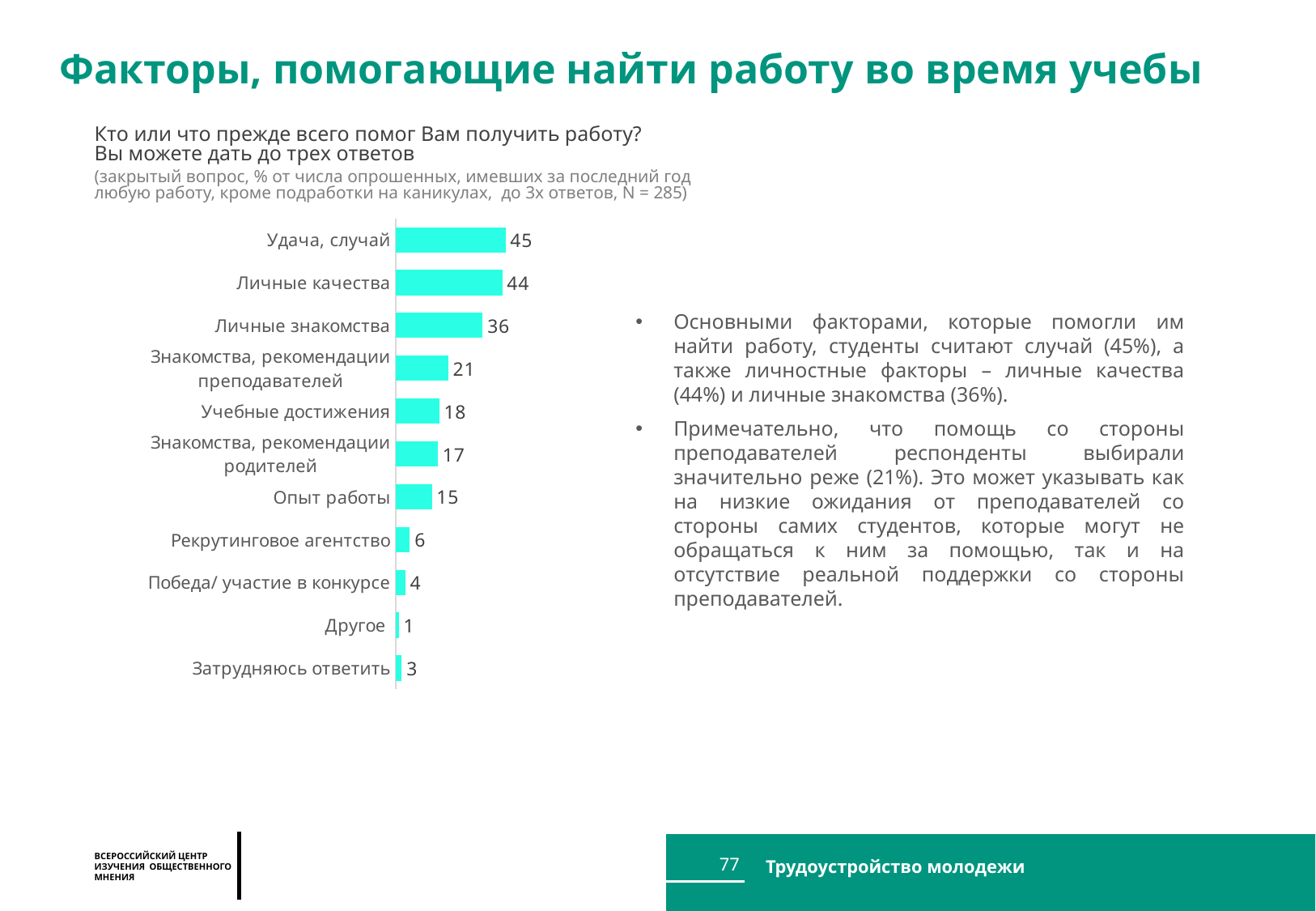
Which category has the lowest value? Другое What value is shown for «Учебные достижения»? 18 What is the difference between «Личные качества» and «Личные знакомства»? 8 What value is shown for «Рекрутинговое агентство»? 6 What is the sample size (N) stated in the chart subtitle? 285 What is the difference between «Знакомства, рекомендации преподавателей» and «Знакомства, рекомендации родителей»? 4 How many categories are shown in the chart? 11 Which category has the highest value? Удача, случай What value is shown for «Затрудняюсь ответить»? 3 What kind of chart is shown on the slide? Bar chart What value is shown for «Удача, случай»? 45 Which is larger: «Опыт работы» or «Учебные достижения»? Учебные достижения